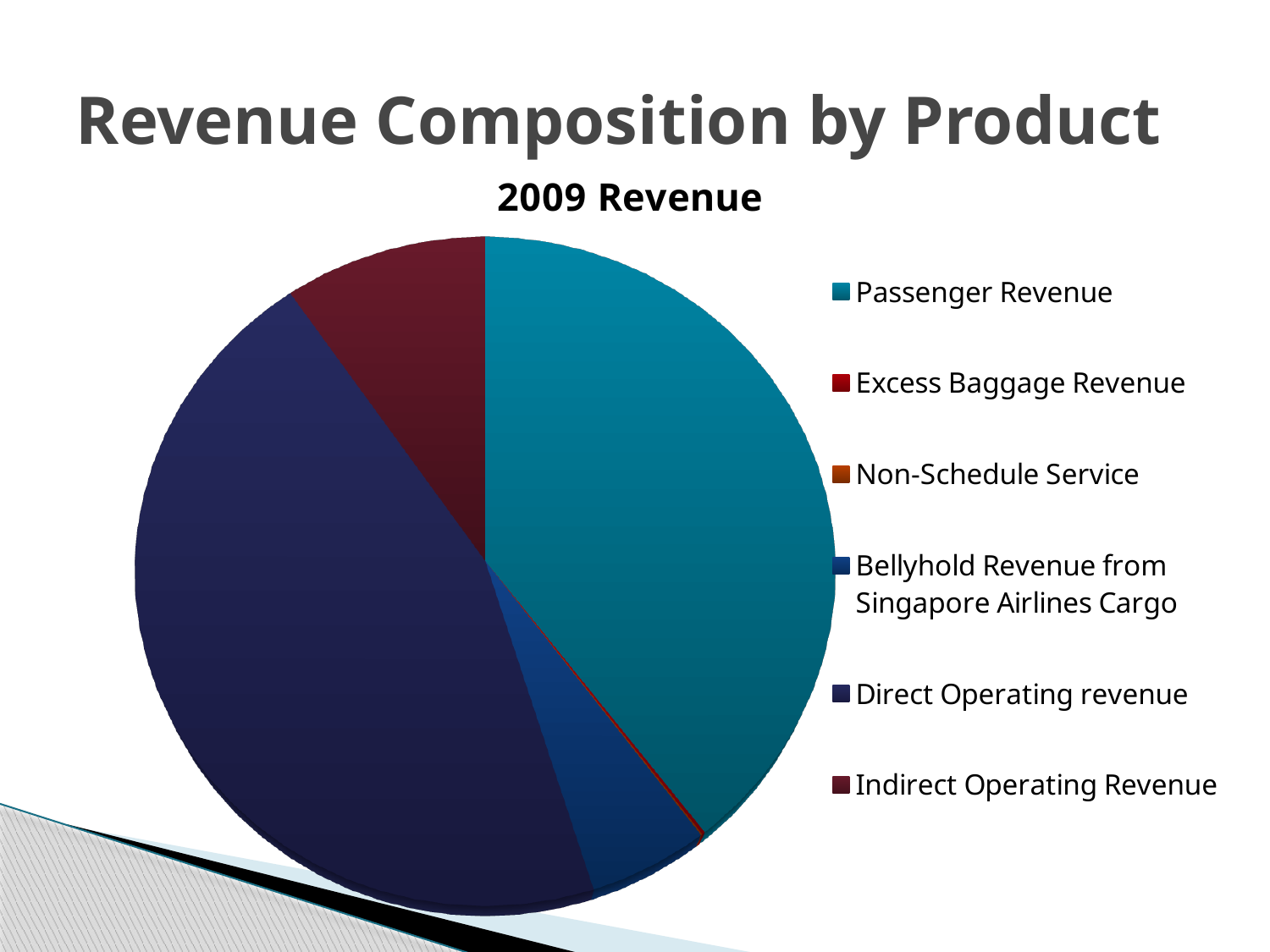
Which slice is larger: Excess Baggage Revenue or Indirect Operating Revenue? Indirect Operating Revenue What kind of chart is shown on the slide? pie chart Which slice is larger: Passenger Revenue or Indirect Operating Revenue? Passenger Revenue Which slice is larger: Indirect Operating Revenue or Bellyhold Revenue from Singapore Airlines Cargo? Indirect Operating Revenue What is the title of the slide? Revenue Composition by Product How many categories does the legend of the pie chart list? 6 What is the title of the pie chart? 2009 Revenue